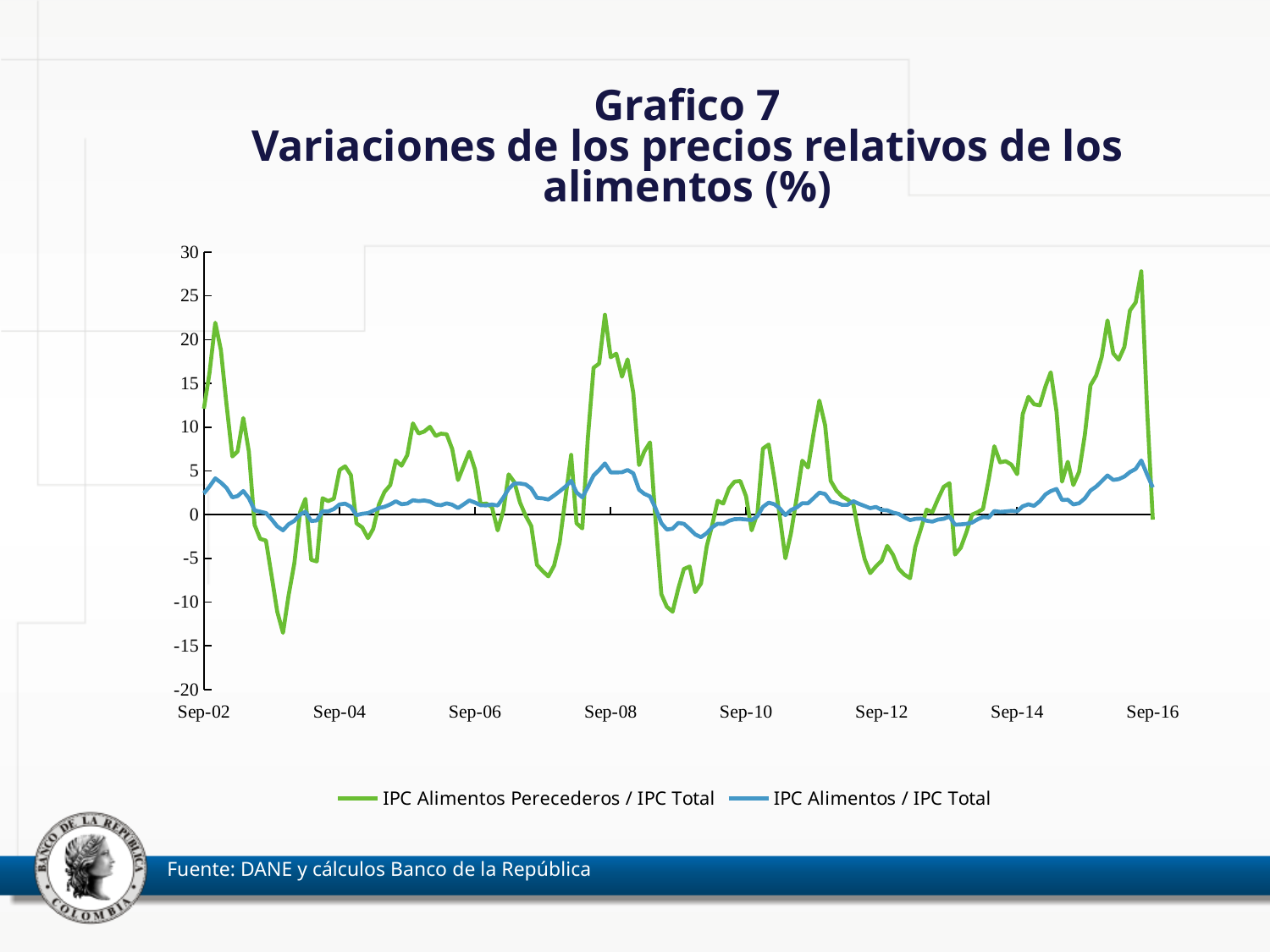
Is the peak of the IPC Alimentos Perecederos / IPC Total series around Sep-08 greater or less than 20? greater Between Sep-14 and mid-2016, does the IPC Alimentos Perecederos / IPC Total series generally rise or fall? rise What is the title of the chart? Grafico 7 Variaciones de los precios relativos de los alimentos (%) Does the IPC Alimentos / IPC Total series ever rise above 10 on the chart? No Which series reaches the higher peak value, IPC Alimentos Perecederos / IPC Total or IPC Alimentos / IPC Total? IPC Alimentos Perecederos / IPC Total Which series is drawn in green according to the legend? IPC Alimentos Perecederos / IPC Total How many date labels are shown on the x axis? 8 How many series does the legend list? 2 What kind of chart is shown on the slide? Line chart Is the highest value reached by the IPC Alimentos Perecederos / IPC Total series (near Sep-16) greater or less than 25? greater